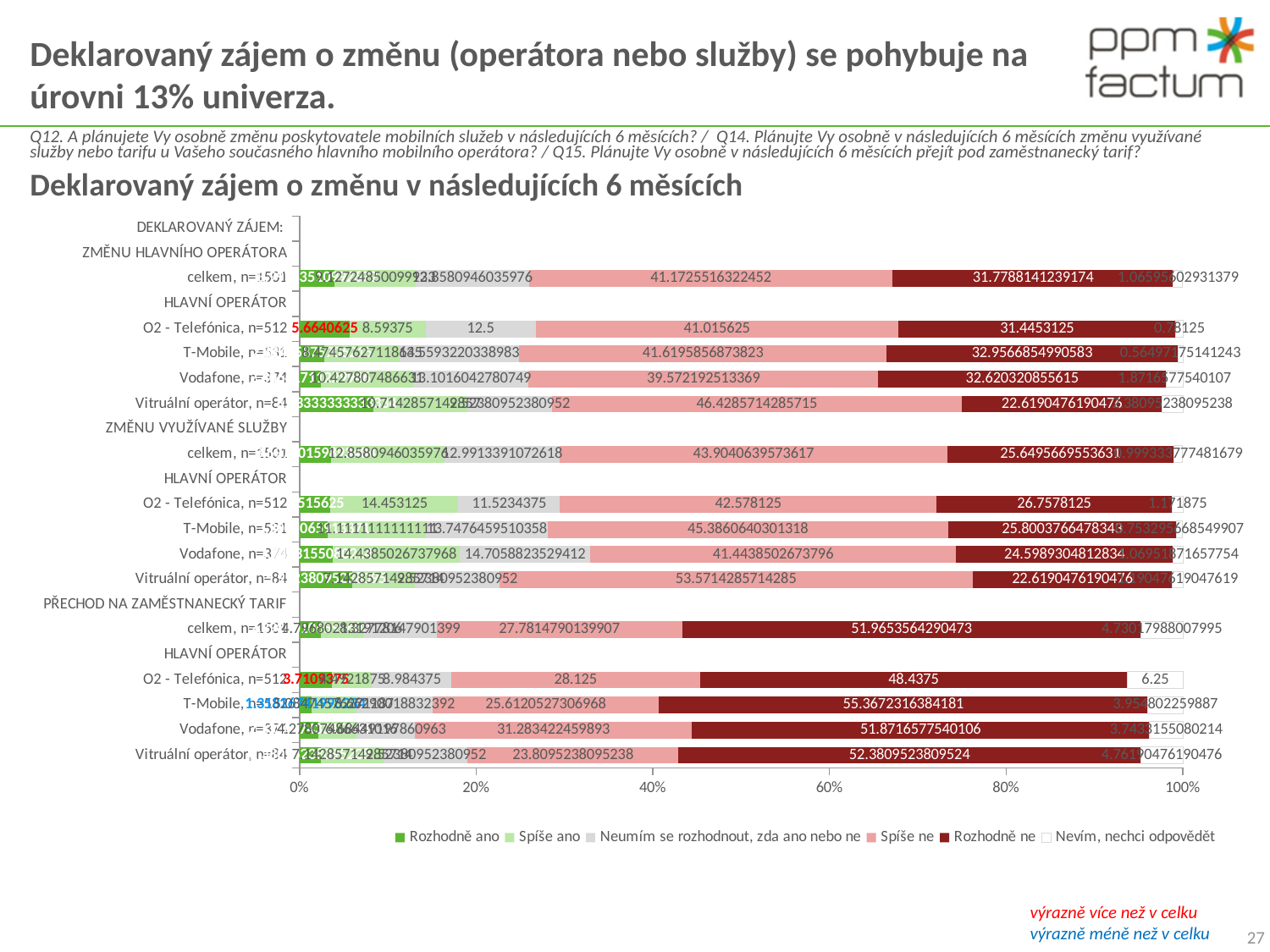
In the "PŘECHOD NA ZAMĚSTNANECKÝ TARIF" section, which operator has the highest "Rozhodně ne" value? T-Mobile What is the value of "Spíše ano" for O2 - Telefónica, n=512 in the "ZMĚNU HLAVNÍHO OPERÁTORA" section? 8.59375 What is the value of "Nevím, nechci odpovědět" for O2 - Telefónica, n=512 in the "PŘECHOD NA ZAMĚSTNANECKÝ TARIF" section? 6.25 What is the difference between "Spíše ne" and "Rozhodně ne" for O2 - Telefónica, n=512 in the "ZMĚNU HLAVNÍHO OPERÁTORA" section? 9.5703125 Is the "Spíše ne" value for Vitruální operátor, n=84 in the "ZMĚNU VYUŽÍVANÉ SLUŽBY" section greater or less than 50? greater What is the value of "Rozhodně ne" for O2 - Telefónica, n=512 in the "PŘECHOD NA ZAMĚSTNANECKÝ TARIF" section? 48.4375 How many series does the legend list? 6 What is the value of "Neumím se rozhodnout, zda ano nebo ne" for O2 - Telefónica, n=512 in the "ZMĚNU VYUŽÍVANÉ SLUŽBY" section? 11.5234375 What is the value of "Spíše ne" for O2 - Telefónica, n=512 in the "ZMĚNU HLAVNÍHO OPERÁTORA" section? 41.015625 What is the title of the chart? Deklarovaný zájem o změnu v následujících 6 měsících What kind of chart is shown on the slide? Stacked horizontal bar chart For O2 - Telefónica, n=512 in the "PŘECHOD NA ZAMĚSTNANECKÝ TARIF" section, which is larger: "Spíše ne" or "Rozhodně ne"? Rozhodně ne